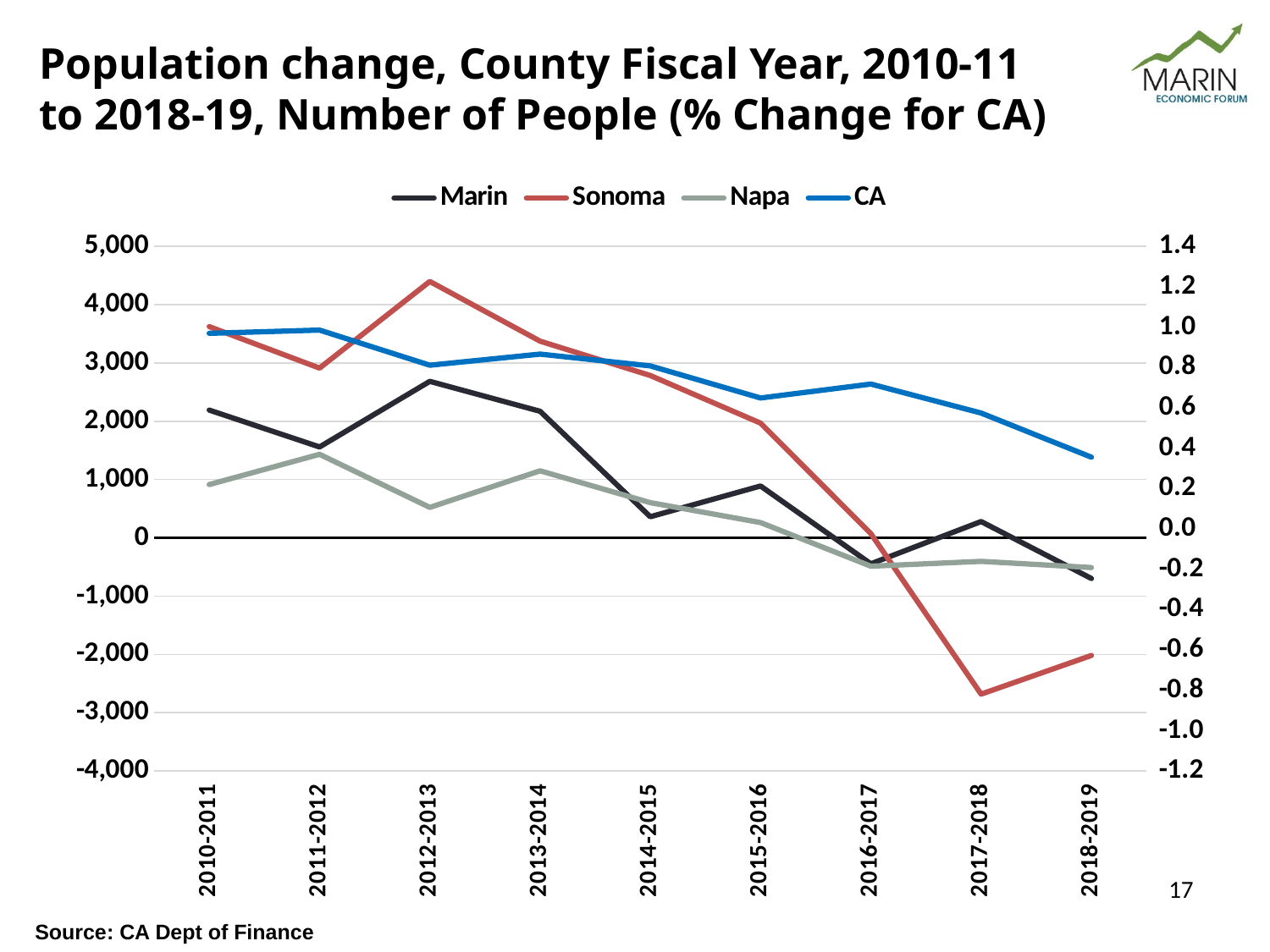
Is the value for Sonoma in 2017-2018 greater or less than -2,000? less In which fiscal year does the CA line reach its lowest value? 2018-2019 In 2017-2018, which is larger, the value for Marin or the value for Sonoma? Marin In which fiscal year does the Sonoma line reach its highest value? 2012-2013 In which fiscal year does the Sonoma line reach its lowest value? 2017-2018 Is the value for Sonoma in 2012-2013 greater or less than 4,000? greater What kind of chart is shown on the slide? line chart In which fiscal year does the Marin line reach its highest value? 2012-2013 Does the CA line generally rise or fall from 2010-2011 to 2018-2019? fall How many fiscal years are plotted along the x axis? 9 Is the value for Napa in 2012-2013 greater or less than 1,000? less How many series does the legend list? 4